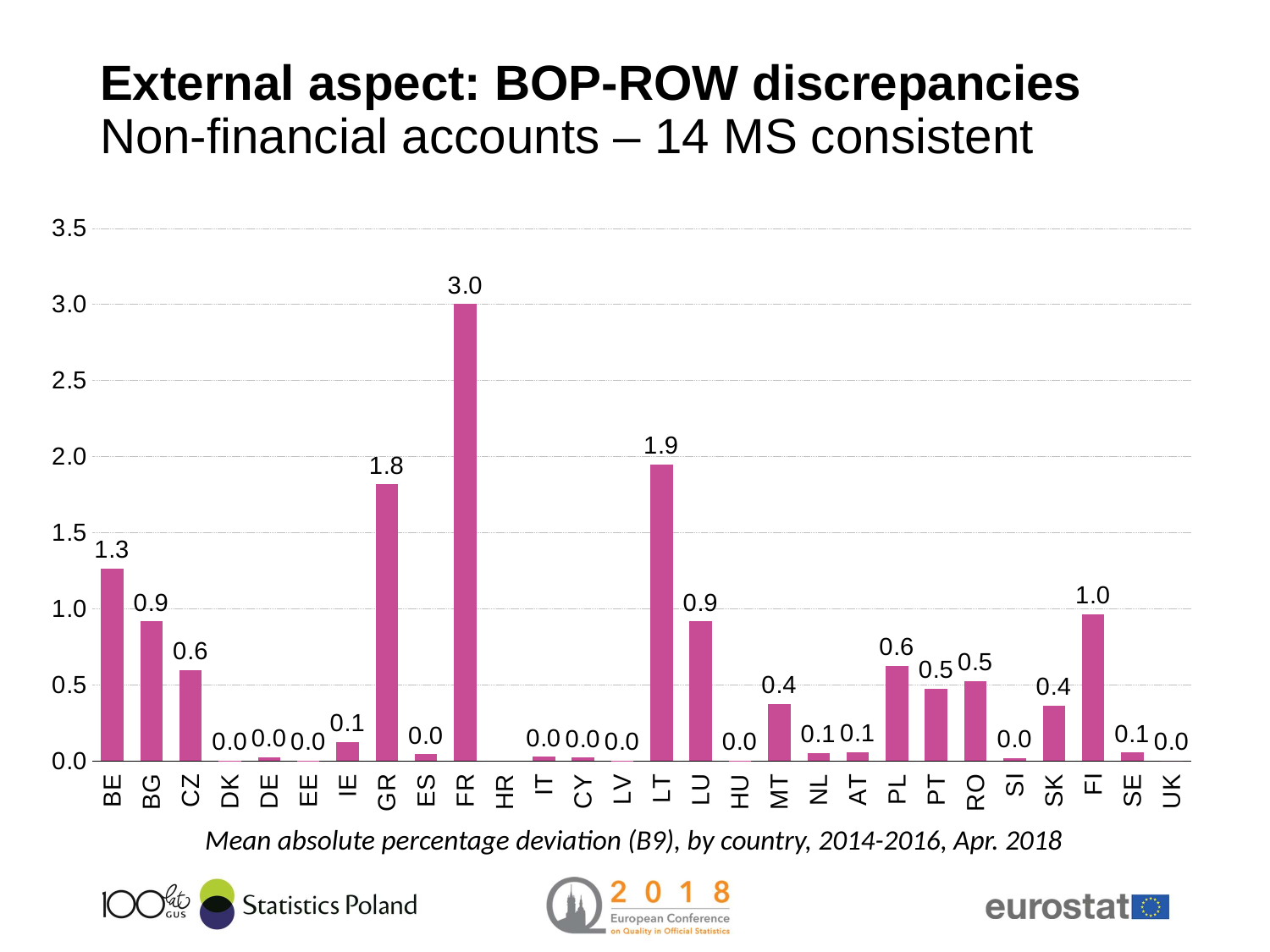
What is the value for FR? 3.0 What is the value for LT? 1.9 What is the value for GR? 1.8 Which has a larger value, PL or MT? PL Is the value for BE greater or less than 1.0? greater What kind of chart is shown on the slide? Bar chart What is the difference between the values for FR and LT? 1.1 What is the difference between the values for BE and BG? 0.4 Which country has the highest value? FR What is the value for FI? 1.0 How many countries are shown on the x axis? 28 What does the caption below the chart say the chart shows? Mean absolute percentage deviation (B9), by country, 2014-2016, Apr. 2018